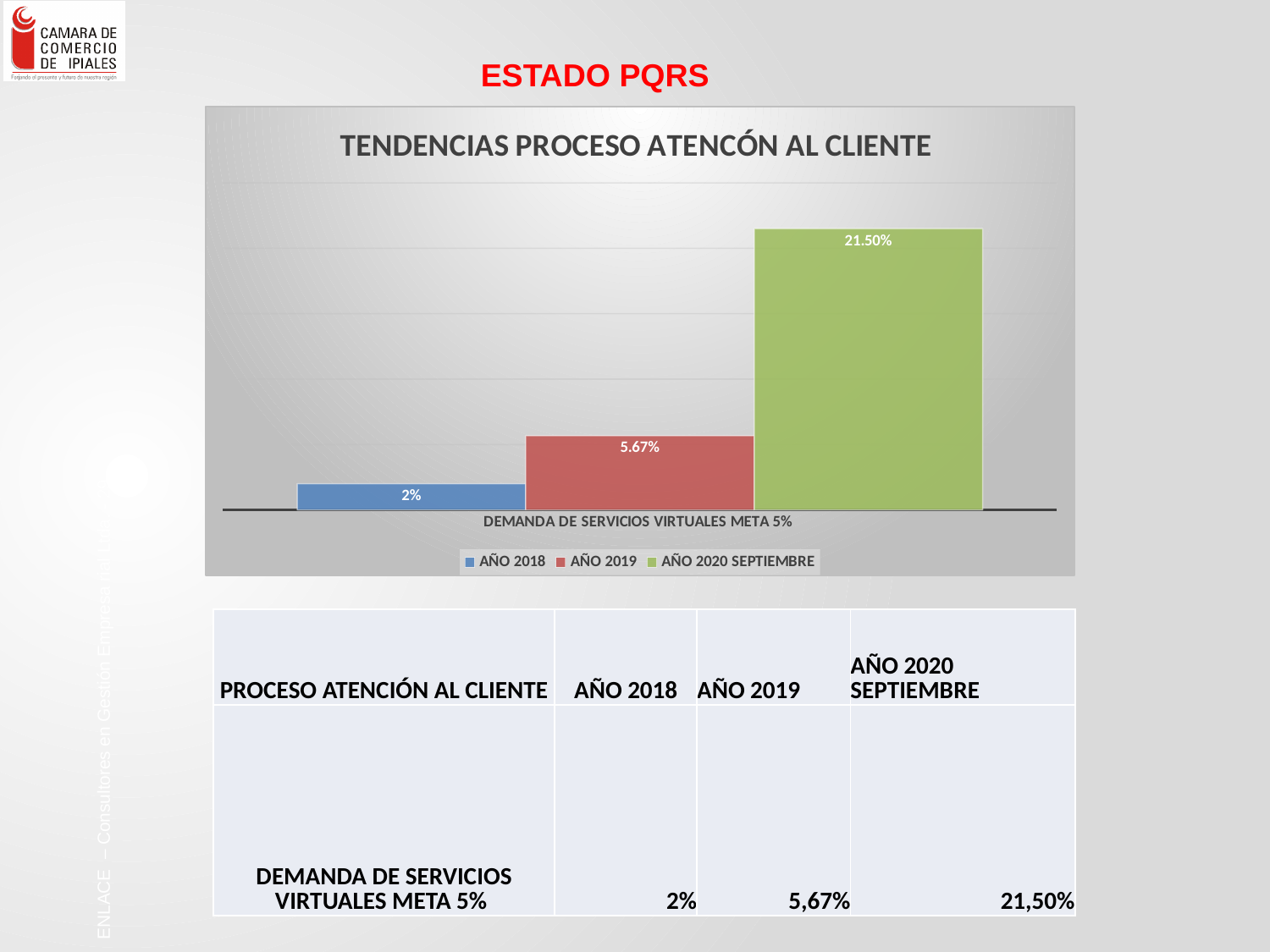
Which series has the highest value in the chart? AÑO 2020 SEPTIEMBRE What is the value for AÑO 2020 SEPTIEMBRE in the chart? 21.50% What is the difference between the AÑO 2019 value and the AÑO 2018 value? 3.67% What is the title of the chart? TENDENCIAS PROCESO ATENCÓN AL CLIENTE How many categories are shown on the x axis of the chart? 1 Which series has the lowest value in the chart? AÑO 2018 What is the value for AÑO 2019 in the chart? 5.67% Which is larger, the value for AÑO 2019 or the value for AÑO 2018? AÑO 2019 How many series does the legend list? 3 What kind of chart is shown on the slide? Bar chart What is the value for AÑO 2018 in the chart? 2% What is the difference between the AÑO 2020 SEPTIEMBRE value and the AÑO 2019 value? 15.83%